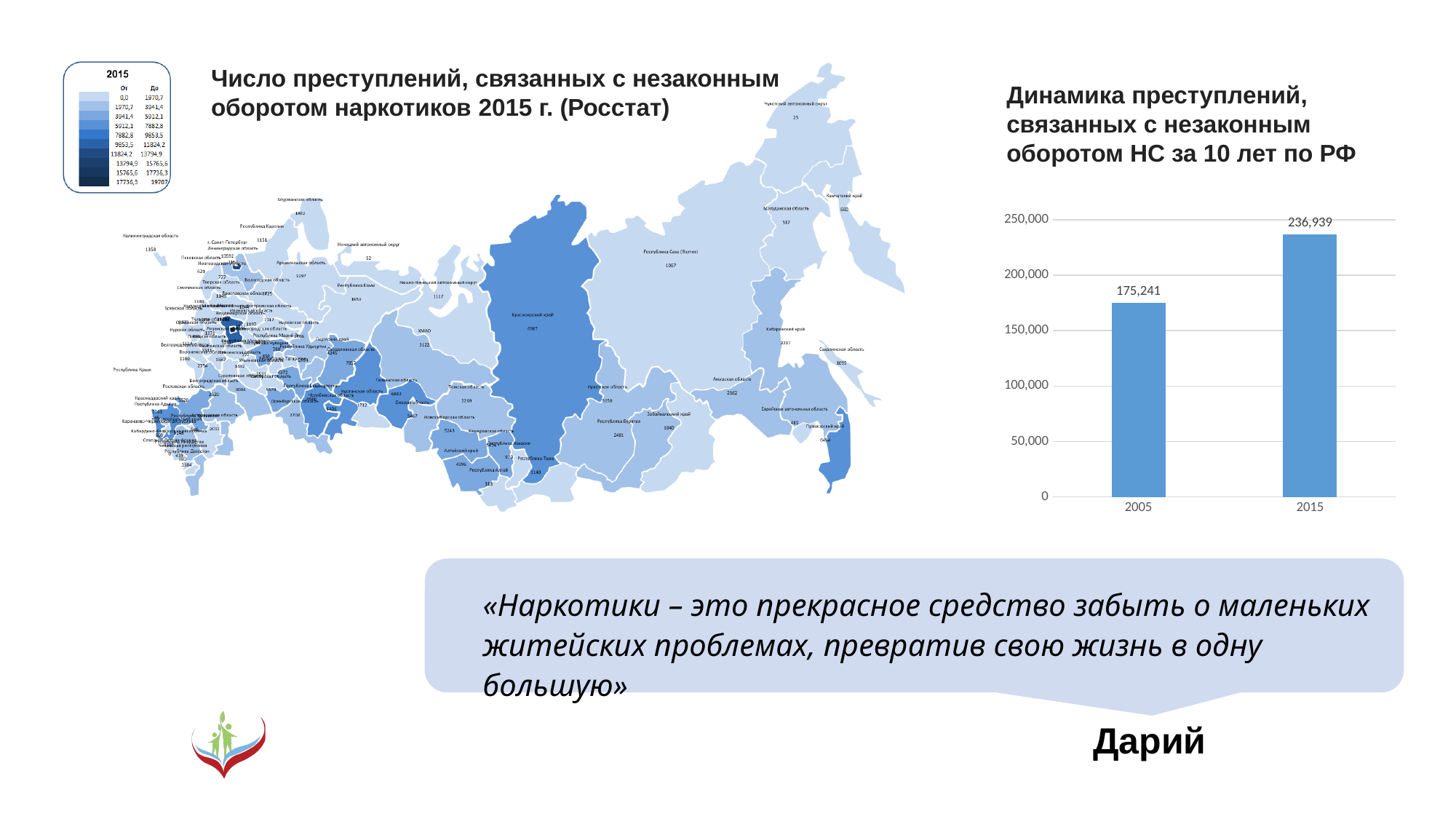
How many bars are shown in the bar chart on the right? 2 In the bar chart on the right, which is larger: the value for 2005 or the value for 2015? 2015 In the bar chart on the right, what is the value for 2015? 236,939 In the bar chart on the right, do the values rise or fall from 2005 to 2015? rise In the bar chart on the right, what is the difference between the 2015 value and the 2005 value? 61,698 In the bar chart on the right (Динамика преступлений, связанных с незаконным оборотом НС за 10 лет по РФ), what is the value for 2005? 175,241 In the bar chart on the right, which year has the highest value? 2015 In the bar chart on the right, is the value for 2005 greater or less than 200,000? less In the bar chart on the right, is the value for 2015 greater or less than 200,000? greater What kind of chart is the chart on the right side of the slide? bar chart What is the title of the bar chart on the right side of the slide? Динамика преступлений, связанных с незаконным оборотом НС за 10 лет по РФ In the bar chart on the right, which year has the lowest value? 2005